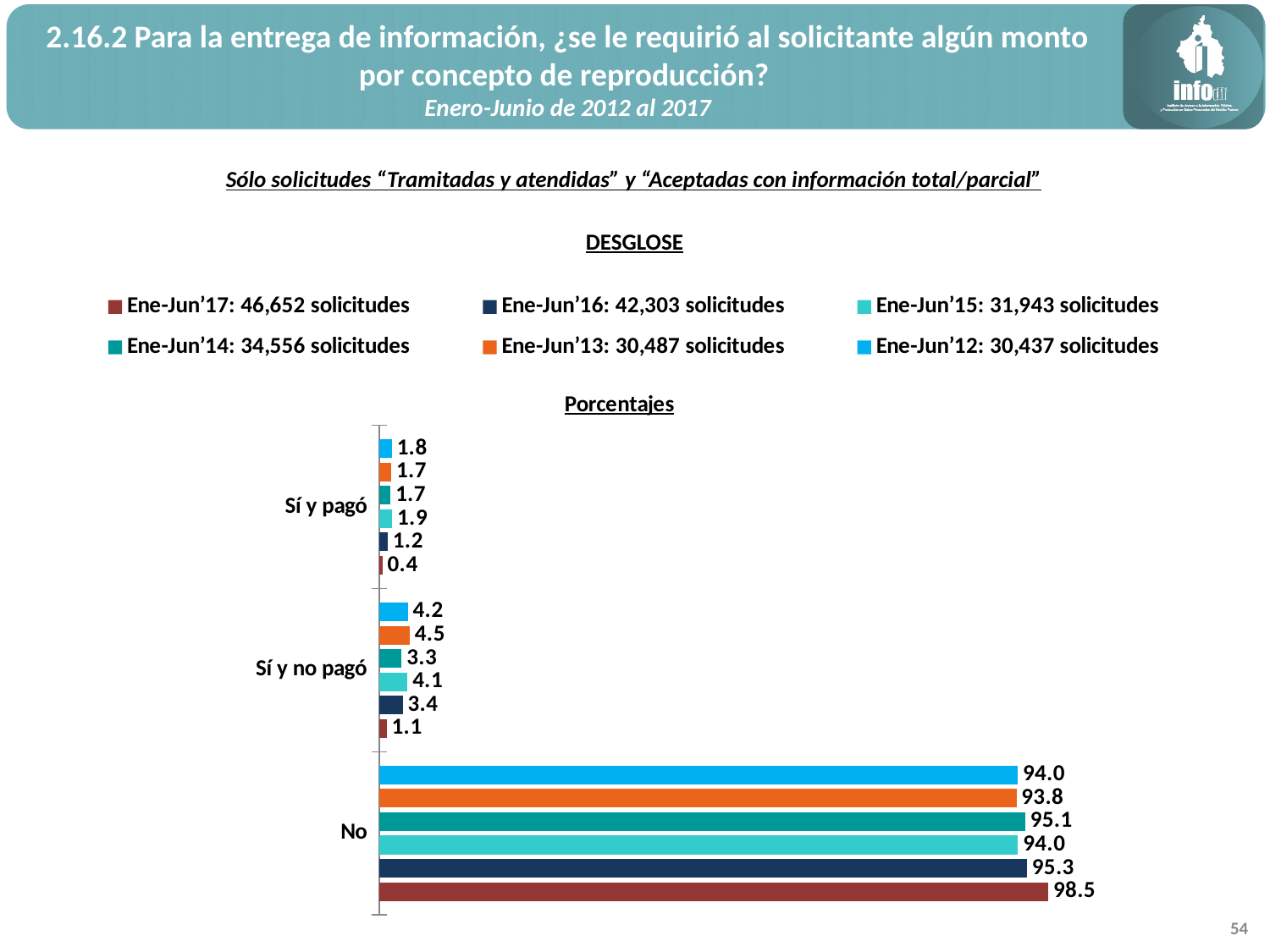
What type of chart is shown on the slide? bar chart What is the value for Ene-Jun'15 in the "Sí y pagó" category? 1.9 What is the difference between the Ene-Jun'12 and Ene-Jun'17 values in the "Sí y no pagó" category? 3.1 Which series has the highest value in the "No" category? Ene-Jun'17 How many series does the legend list? 6 What is the value for Ene-Jun'13 in the "Sí y no pagó" category? 4.5 What is the value for Ene-Jun'17 in the "No" category? 98.5 In the "Sí y no pagó" category, which is larger: the value for Ene-Jun'13 or the value for Ene-Jun'14? Ene-Jun'13 How many categories are shown on the chart's vertical axis? 3 What is the difference between the Ene-Jun'17 and Ene-Jun'12 values in the "No" category? 4.5 How many solicitudes does the legend give for Ene-Jun'16? 42,303 solicitudes Which series has the lowest value in the "Sí y pagó" category? Ene-Jun'17